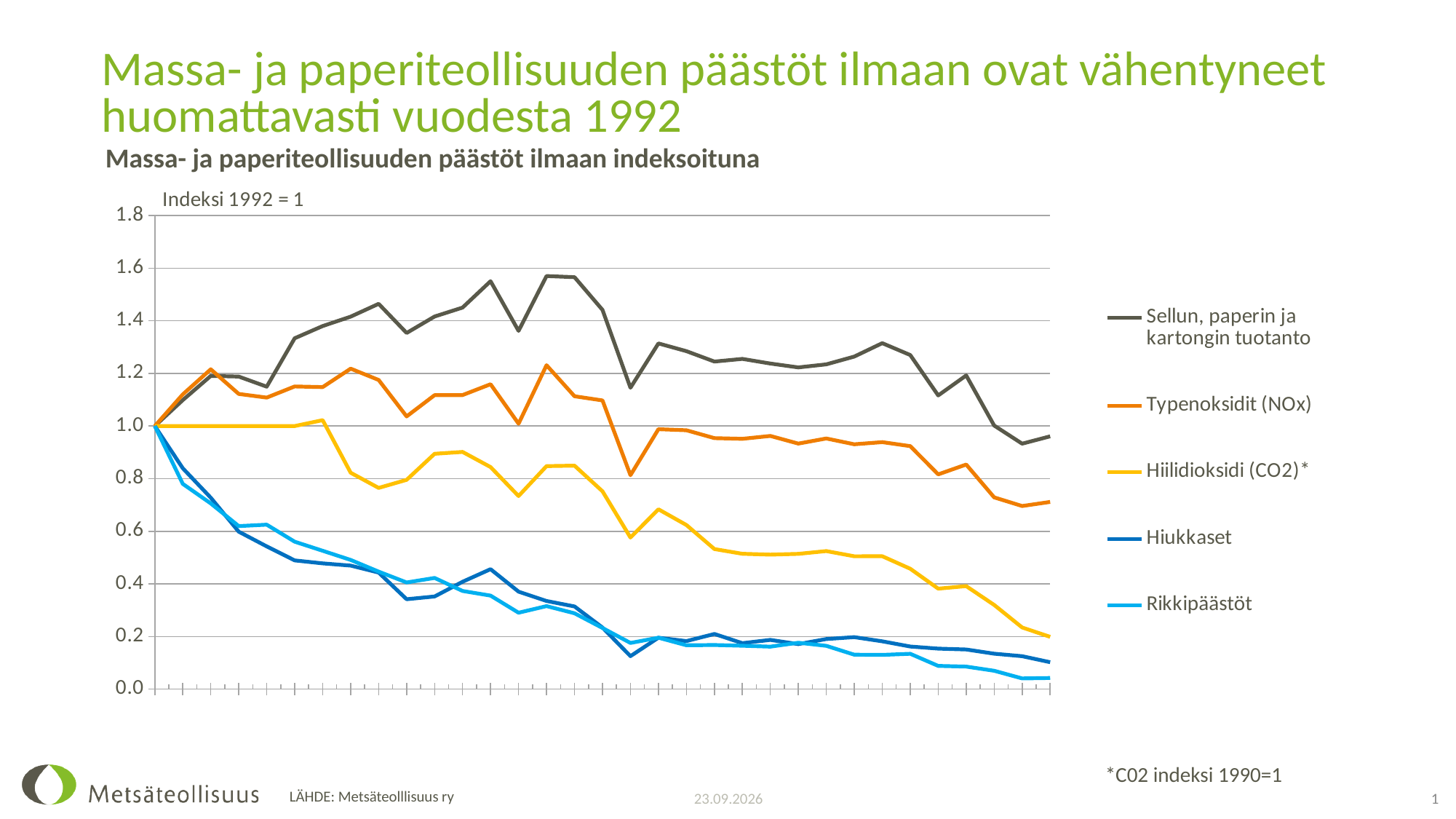
What kind of chart is shown on the slide? line chart Do the values for Rikkipäästöt rise or fall along the x axis? fall Is the final value for Rikkipäästöt at the right end of the chart greater or less than 0.2? less Is the final value for Typenoksidit (NOx) at the right end of the chart greater or less than 0.6? greater At the right end of the chart, which is higher: Typenoksidit (NOx) or Hiilidioksidi (CO2)*? Typenoksidit (NOx) Is the final value for Hiilidioksidi (CO2)* at the right end of the chart greater or less than 0.4? less Do the values for Hiilidioksidi (CO2)* rise or fall overall along the x axis? fall How many series does the legend list? 5 Which series is drawn in yellow? Hiilidioksidi (CO2)* Which series reaches the highest value anywhere on the chart? Sellun, paperin ja kartongin tuotanto What is the title of the chart? Massa- ja paperiteollisuuden päästöt ilmaan indeksoituna